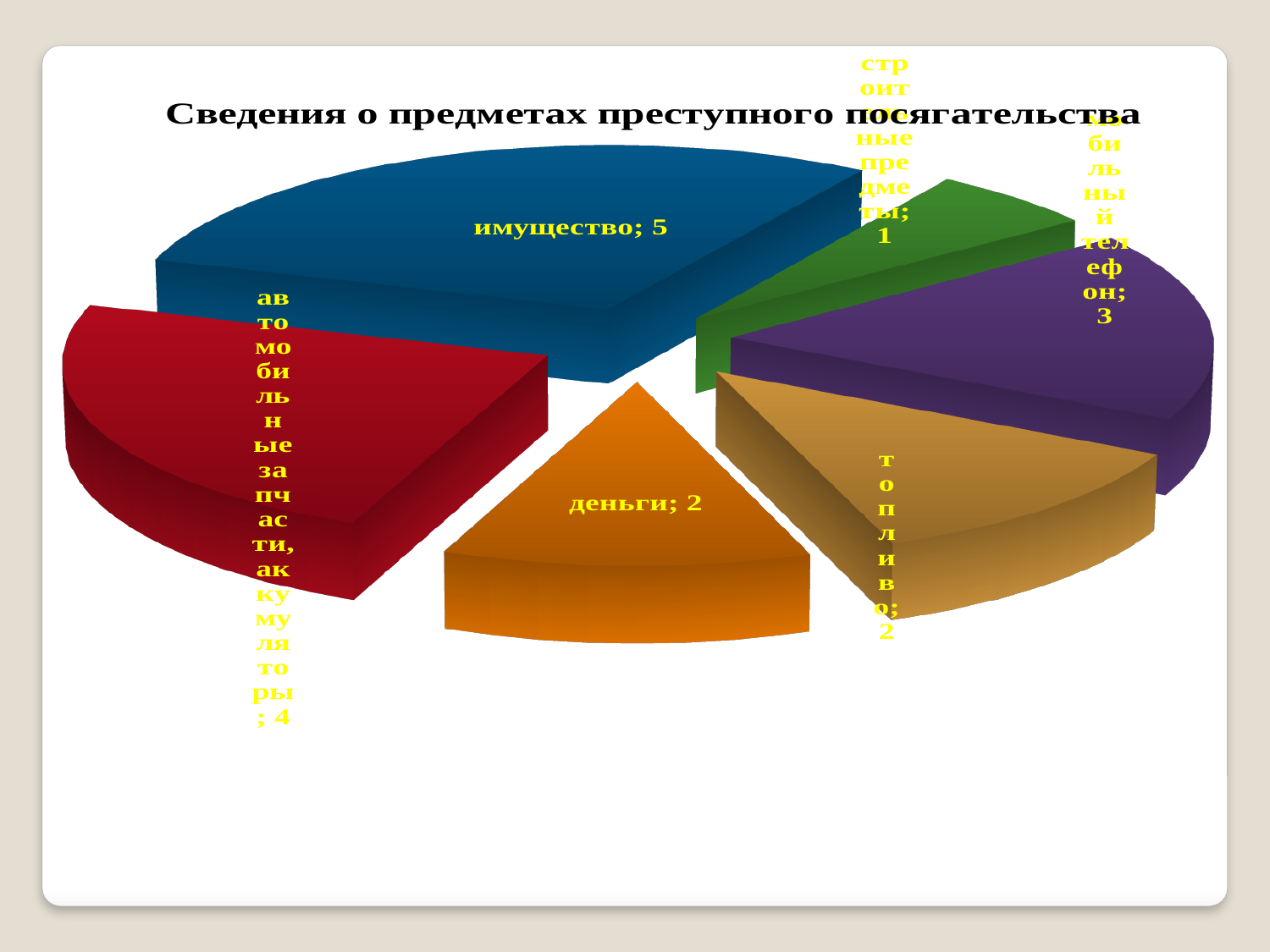
What is the value for топливо? 2 What kind of chart is shown on the slide? pie chart What is the value for деньги? 2 What is the value for имущество? 5 What colour is the slice for имущество? blue What is the title of the chart? Сведения о предметах преступного посягательства Which category has the largest value? имущество What is the value for мобильный телефон? 3 What is the value for автомобильные запчасти, аккумуляторы? 4 How many slices does the pie chart have? 6 What is the difference between the values for имущество and мобильный телефон? 2 Which is larger: the value for автомобильные запчасти, аккумуляторы or the value for мобильный телефон? автомобильные запчасти, аккумуляторы